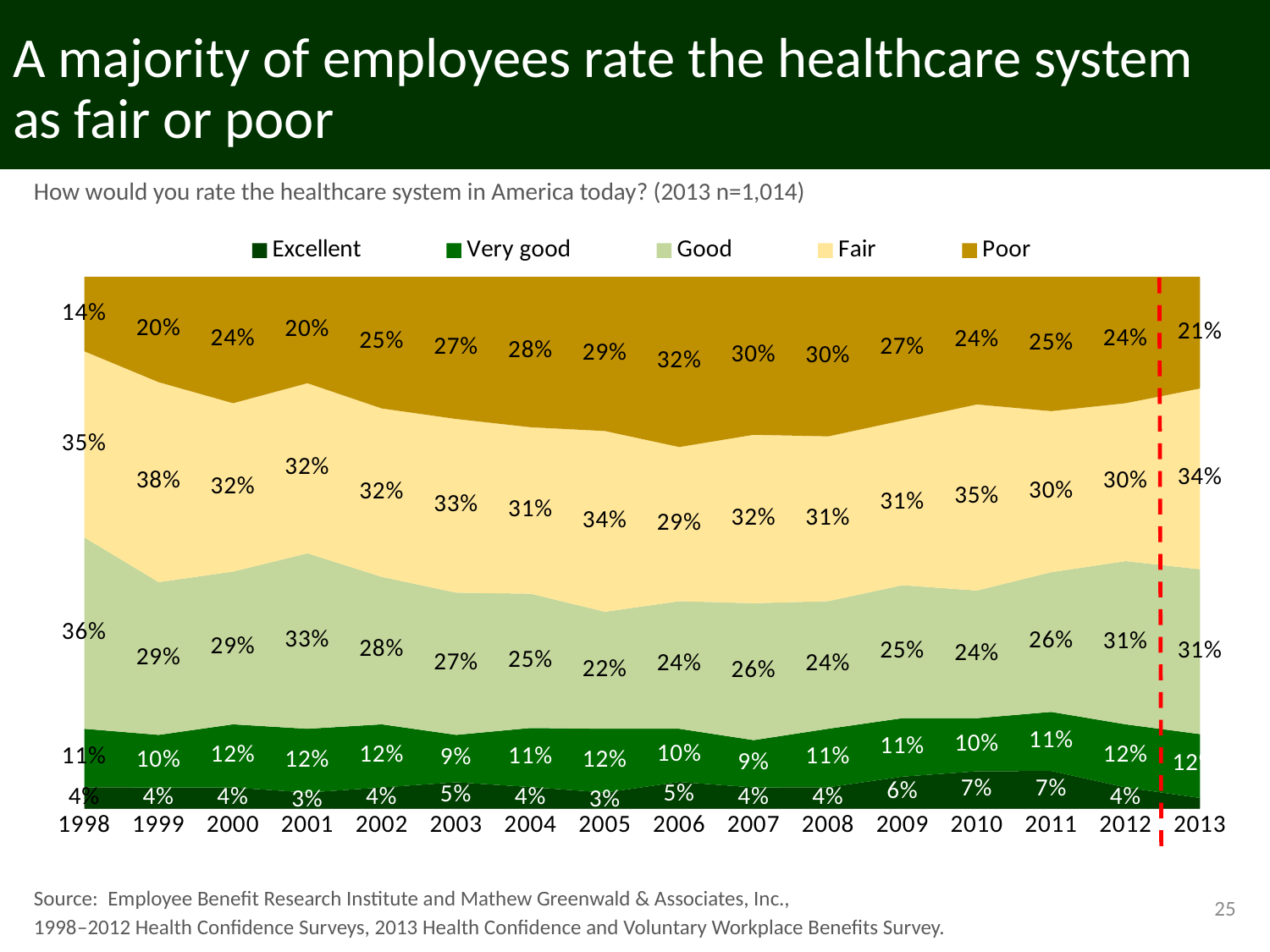
In which year was the Poor rating at its lowest? 1998 How many series does the legend list? 5 How many years are shown along the x axis? 16 What percentage of employees rated the healthcare system as Excellent in 2010? 7% In which year was the Poor rating at its highest? 2006 Which was larger in 2005: the share rating the system Fair or the share rating it Good? Fair What percentage of employees rated the healthcare system as Fair in 1999? 38% What is the combined share of Fair and Poor ratings in 2013? 55% What percentage of employees rated the healthcare system as Good in 2013? 31% What percentage of employees rated the healthcare system as Poor in 2006? 32% What kind of chart is shown on the slide? Stacked area chart What is the difference between the Poor rating in 2006 and the Poor rating in 2013? 11 percentage points